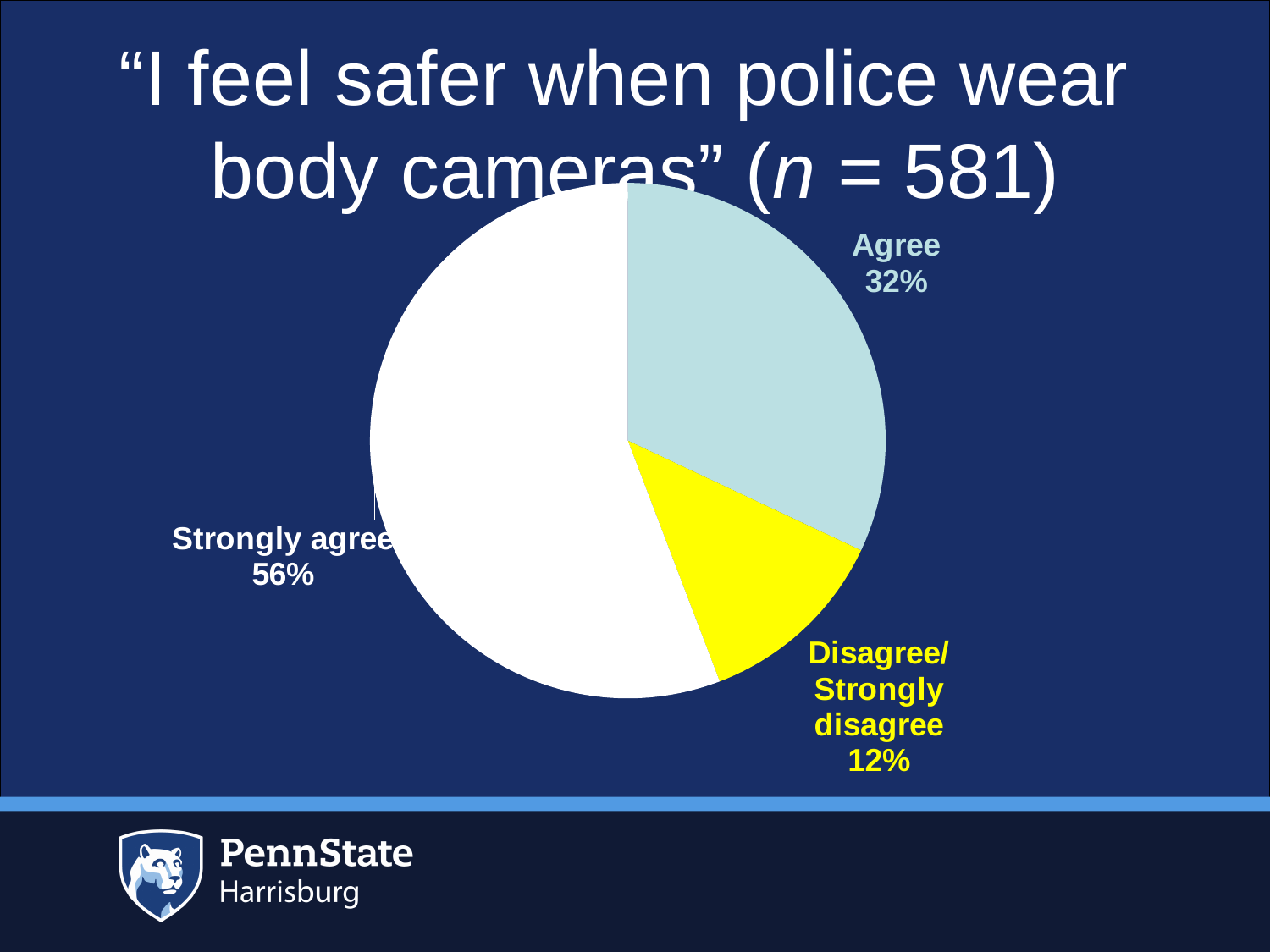
Which response category has the smallest share of the pie? Disagree/Strongly disagree What percentage of respondents chose "Strongly agree"? 56% What is the sample size (n) stated in the chart title? 581 Which response category has the largest share of the pie? Strongly agree What colour is the "Disagree/Strongly disagree" slice? yellow What is the difference in percentage points between "Strongly agree" and "Agree"? 24 Which is larger, the share for "Agree" or the share for "Disagree/Strongly disagree"? Agree What percentage of respondents chose "Disagree/Strongly disagree"? 12% What is the difference in percentage points between "Agree" and "Disagree/Strongly disagree"? 20 How many slices does the pie chart have? 3 What kind of chart is shown on the slide? pie chart What percentage of respondents chose "Agree"? 32%